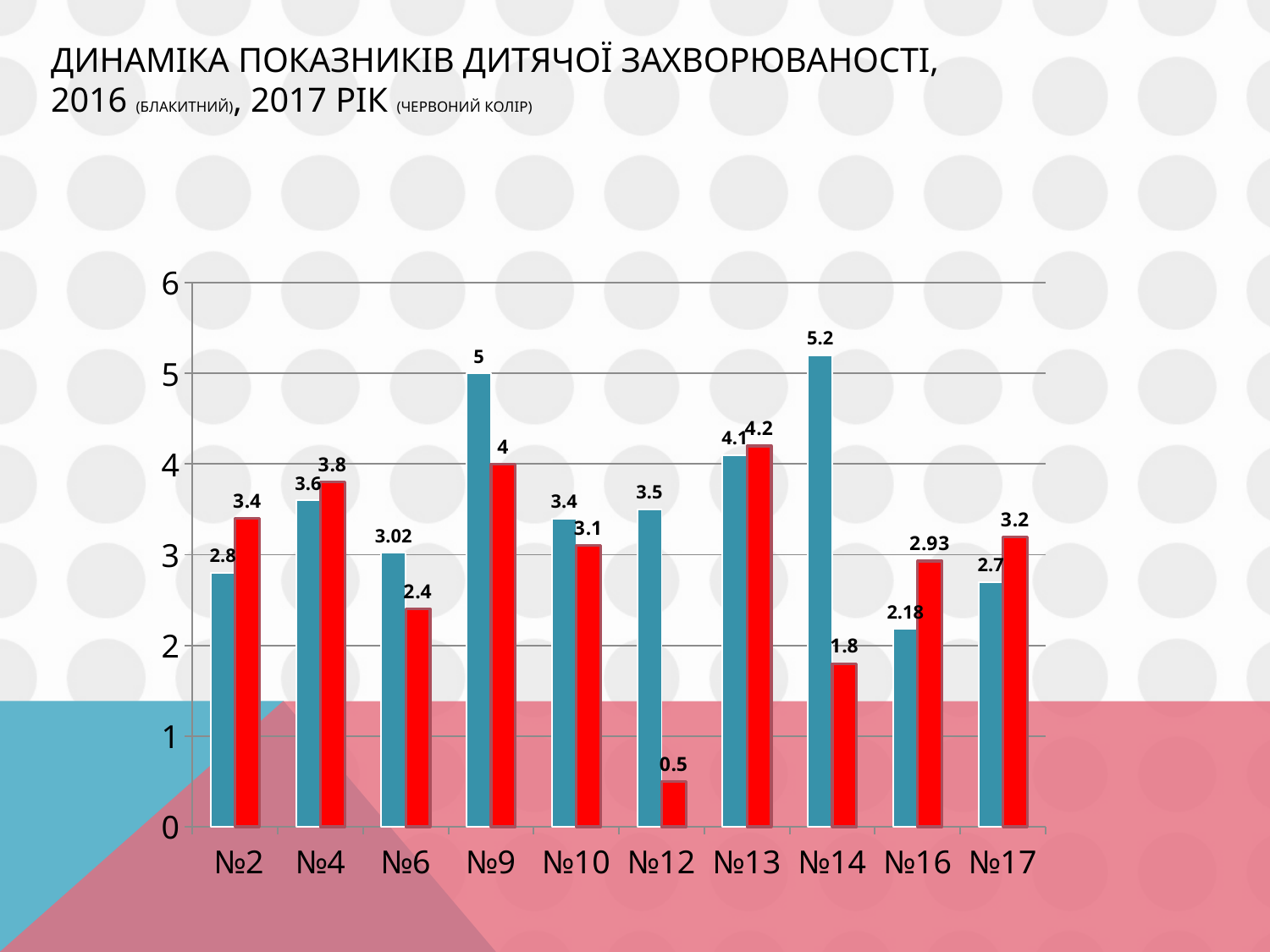
Which category has the lowest 2017 value? №12 Which category has the highest 2016 value? №14 What is the 2016 value for №9? 5 Which colour represents the year 2017 in the chart? Red How many categories are shown on the x axis? 10 What is the 2017 value for №12? 0.5 What is the difference between the 2016 and 2017 values for №12? 3 Which category has the highest 2017 value? №13 What kind of chart is shown on the slide? Bar chart For №6, which year has the larger value, 2016 or 2017? 2016 What is the difference between the 2016 and 2017 values for №14? 3.4 What is the 2017 value for №16? 2.93